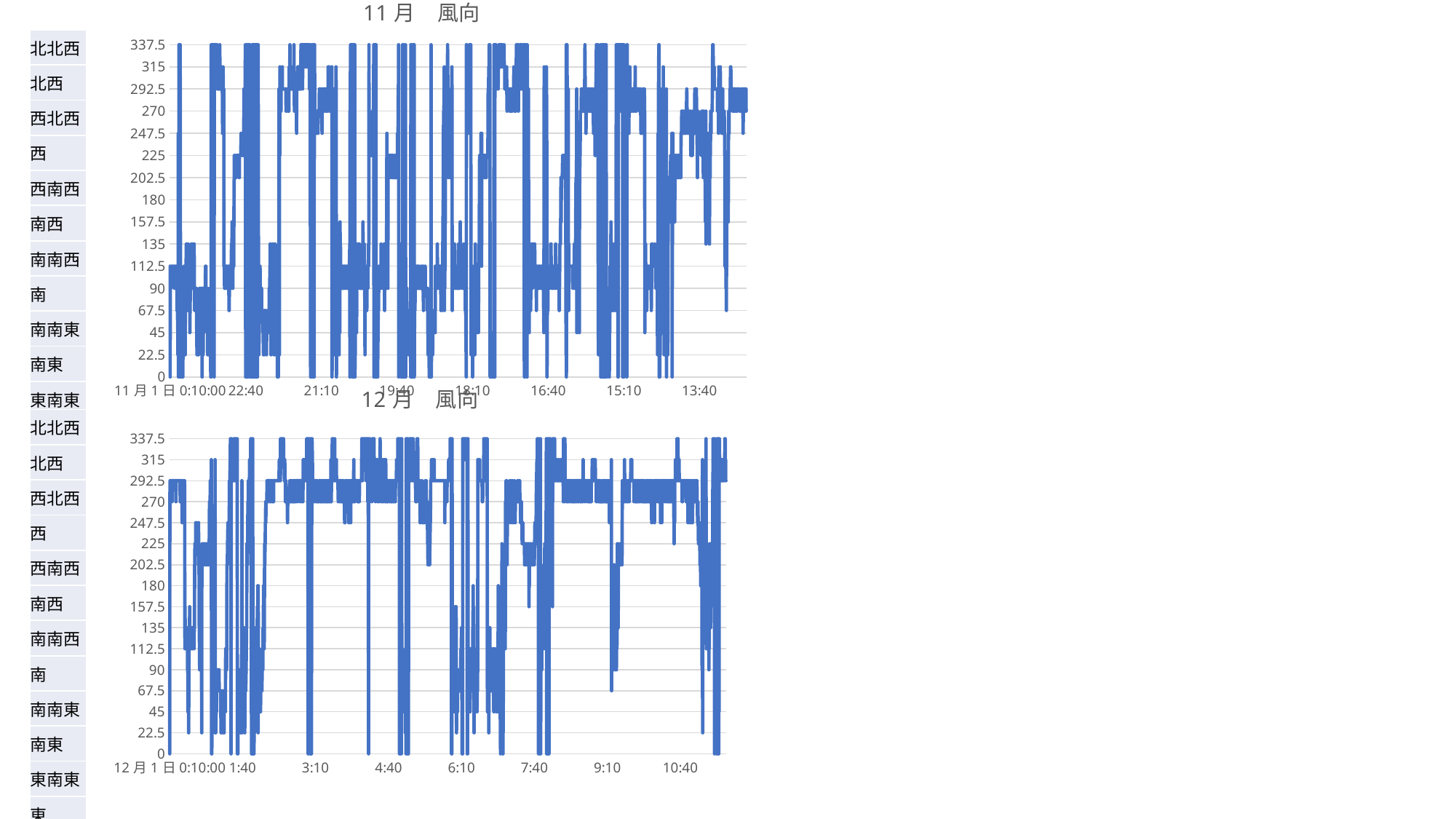
In the 12月 風向 chart, what is the first label shown on the horizontal axis? 12月1日 0:10:00 What is the title of the top chart on the slide? 11月 風向 What kind of chart is the top chart titled 11月 風向? line chart What kind of chart is the bottom chart titled 12月 風向? line chart What is the title of the bottom chart on the slide? 12月 風向 In the 11月 風向 chart, what is the first label shown on the horizontal axis? 11月1日 0:10:00 In the 11月 風向 chart, what is the highest tick value shown on the vertical axis? 337.5 In the 12月 風向 chart, what is the last time label shown on the horizontal axis? 10:40 In the 11月 風向 chart, what is the last time label shown on the horizontal axis? 13:40